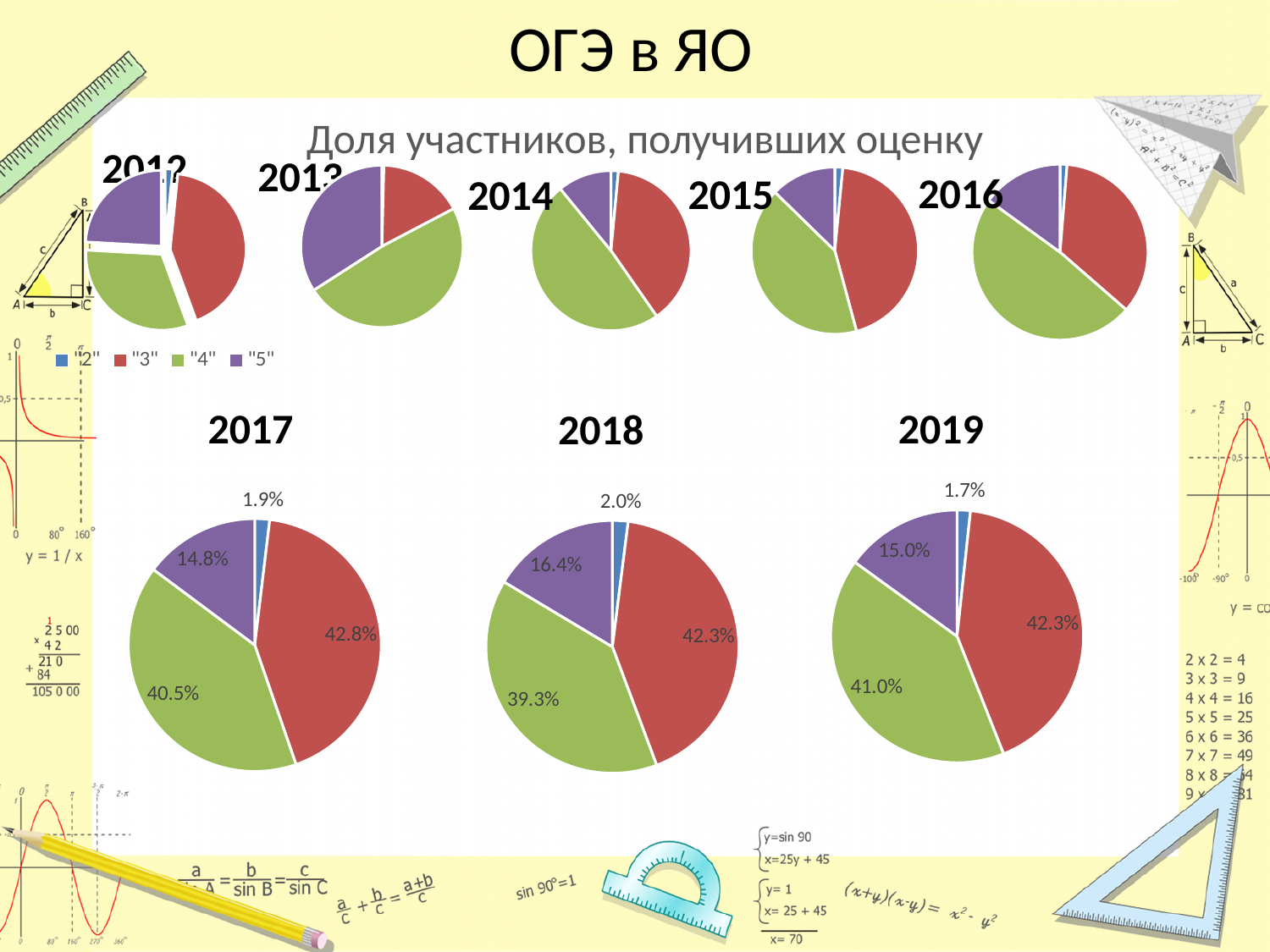
In the 2019 pie chart, what is the difference between the share for grade "3" and the share for grade "4"? 1.3 percentage points In the 2018 pie chart, what share of participants received the grade "4"? 39.3% In the 2017 pie chart, what share of participants received the grade "3"? 42.8% In the 2017 pie chart, which grade has the largest share? "3" How many entries does the legend list? 4 In the 2017 pie chart, what is the difference between the share for grade "3" and the share for grade "5"? 28.0 percentage points In the 2018 pie chart, which grade has the smallest share? "2" In the 2019 pie chart, what share of participants received the grade "2"? 1.7% Which year has the larger share of grade "5": the 2017 pie chart or the 2018 pie chart? 2018 According to the legend, which colour represents the grade "4"? Green What kind of charts are shown on the slide? Pie charts How many pie charts are shown on the slide? 8